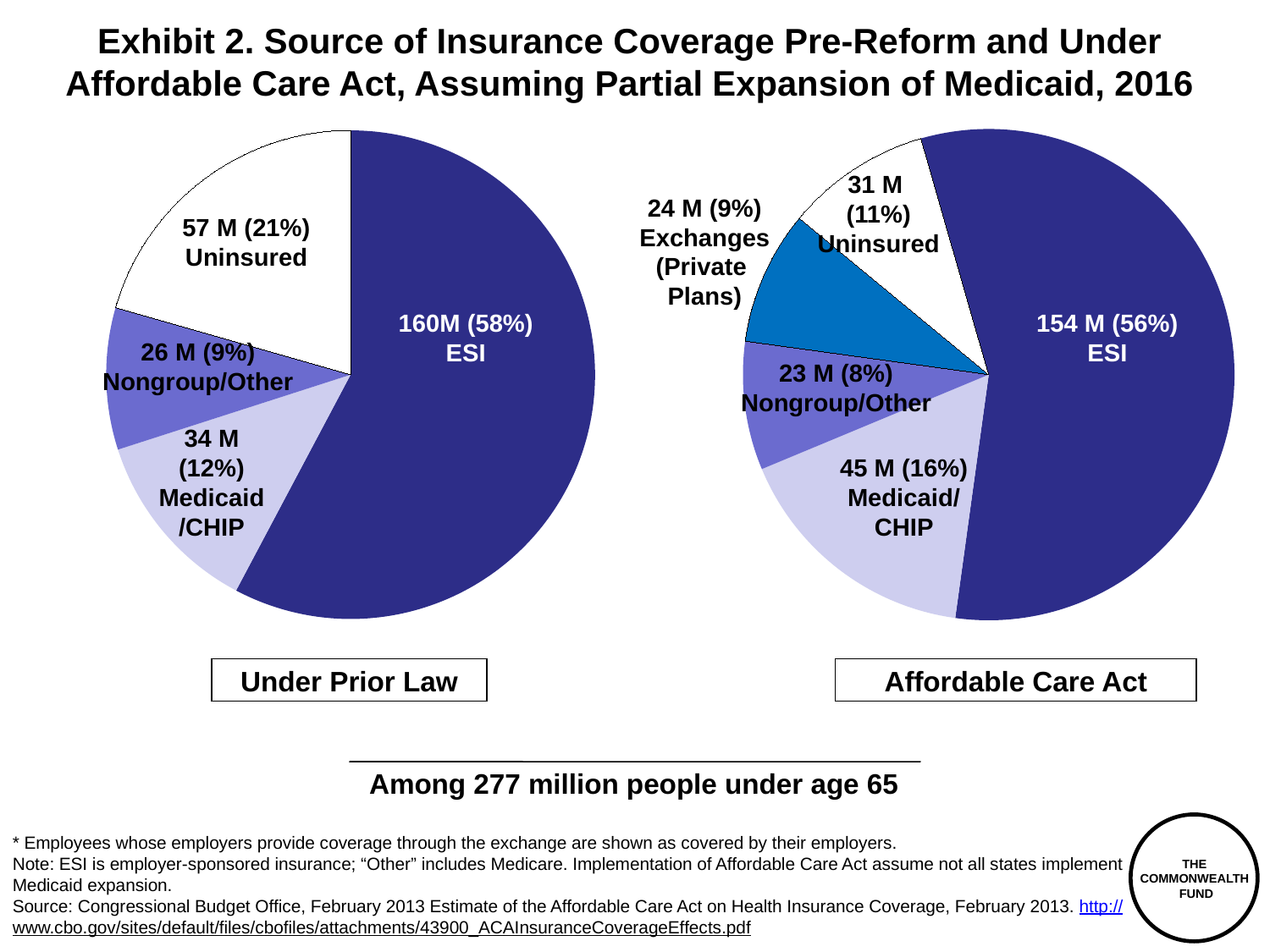
How many slices does the 'Affordable Care Act' pie chart have? 5 In the 'Under Prior Law' pie chart, how many people are covered by ESI? 160M (58%) What is the difference in millions between Uninsured under prior law and Uninsured under the Affordable Care Act? 26 M In the 'Affordable Care Act' pie chart, what is the value for Exchanges (Private Plans)? 24 M (9%) How many slices does the 'Under Prior Law' pie chart have? 4 In the 'Under Prior Law' pie chart, what share of the pie is Uninsured? 21% In the 'Affordable Care Act' pie chart, which category has the smallest slice? Nongroup/Other Which is larger: Medicaid/CHIP under prior law or Medicaid/CHIP under the Affordable Care Act? Medicaid/CHIP under the Affordable Care Act In the 'Under Prior Law' pie chart, which category has the largest slice? ESI What type of chart is used on this slide? Pie chart In the 'Affordable Care Act' pie chart, what share of the pie is Medicaid/CHIP? 16% In the 'Affordable Care Act' pie chart, how many people are uninsured? 31 M (11%)